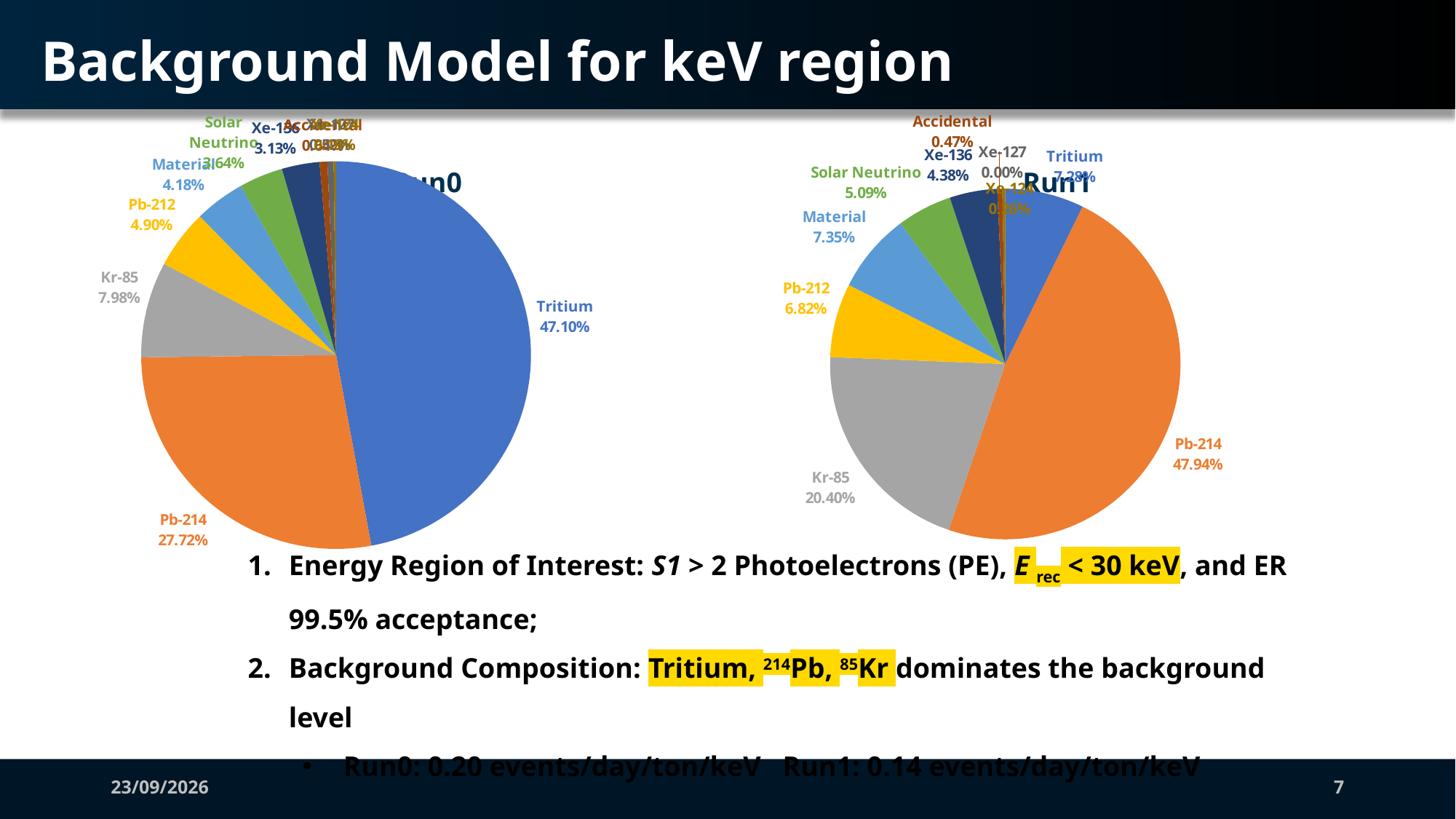
In the Run1 pie chart, how many percentage points larger is Pb-214 than Kr-85? 27.54% What type of chart is used for Run0 and Run1 on this slide? Pie chart In the Run1 pie chart, what is the percentage for Kr-85? 20.40% In the Run0 pie chart, what share does Tritium have? 47.10% In the Run0 pie chart, what is the percentage for Pb-214? 27.72% In the Run0 pie chart, which component has the largest share? Tritium In the Run1 pie chart, what share does Pb-214 have? 47.94% In the Run0 pie chart, how many percentage points larger is Tritium than Pb-214? 19.38% In the Run1 pie chart, what is the percentage for Solar Neutrino? 5.09% In the Run1 pie chart, which component has the largest share? Pb-214 In the Run0 pie chart, what is the percentage for Kr-85? 7.98% In the Run0 pie chart, which is larger, Kr-85 or Pb-212? Kr-85